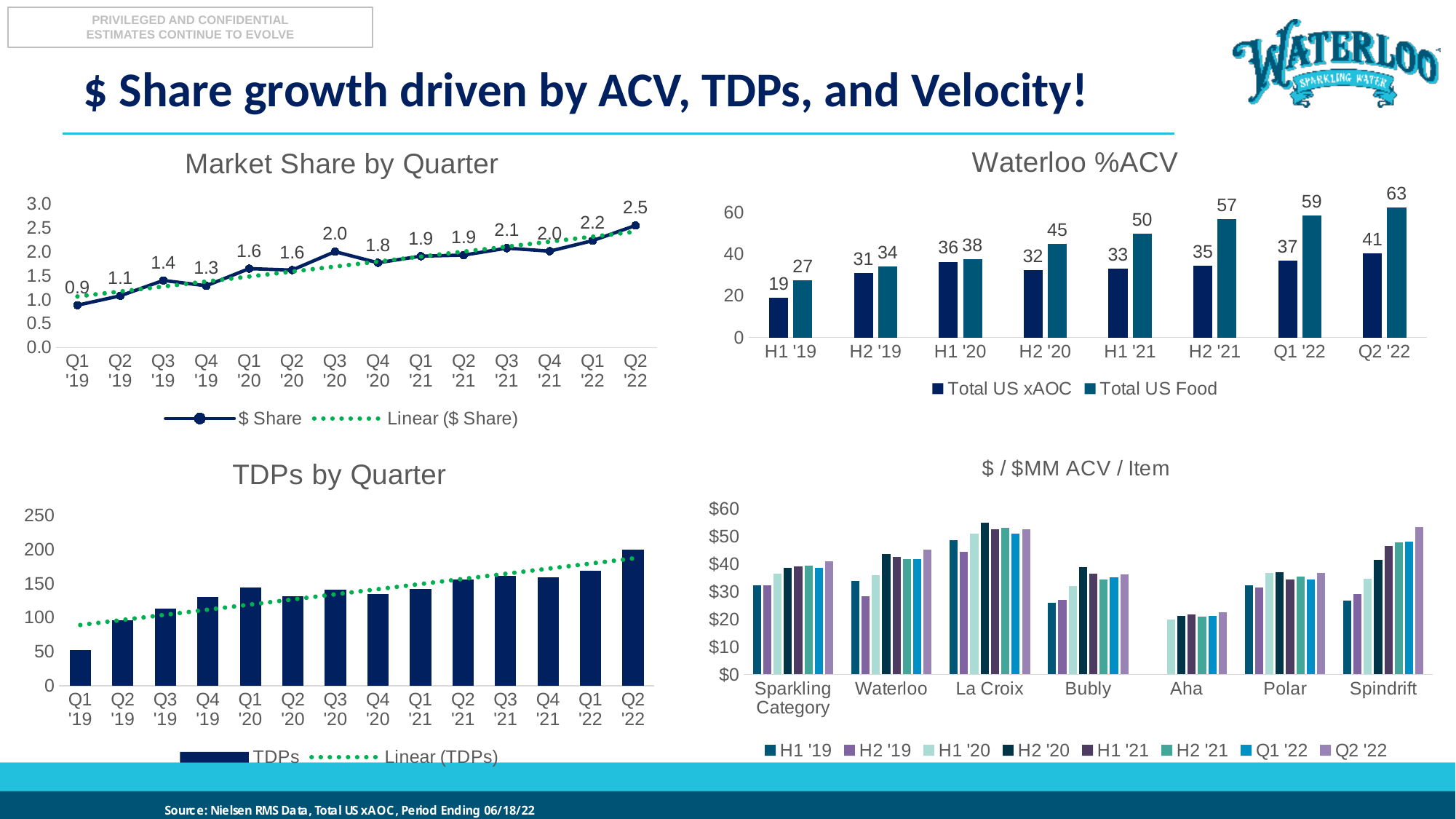
In the Market Share by Quarter chart, what is the $ Share value for Q2 '22? 2.5 In the Waterloo %ACV chart, how many series does the legend list? 2 In the TDPs by Quarter chart, is the TDPs value for Q2 '22 greater or less than 150? greater In the Waterloo %ACV chart, what is the Total US xAOC value for H1 '20? 36 In the Waterloo %ACV chart, which period has the highest Total US Food value? Q2 '22 In the Market Share by Quarter chart, what is the $ Share value for Q1 '19? 0.9 In the Market Share by Quarter chart, what is the difference between the $ Share values for Q3 '19 and Q4 '19? 0.1 In the TDPs by Quarter chart, is the TDPs value for Q1 '19 greater or less than 100? less In the Waterloo %ACV chart, what is the Total US Food value for H2 '21? 57 In the $ / $MM ACV / Item chart, how many series does the legend list? 8 In the Market Share by Quarter chart, how many quarters are plotted? 14 In the Waterloo %ACV chart, what is the difference between Total US Food and Total US xAOC in Q2 '22? 22